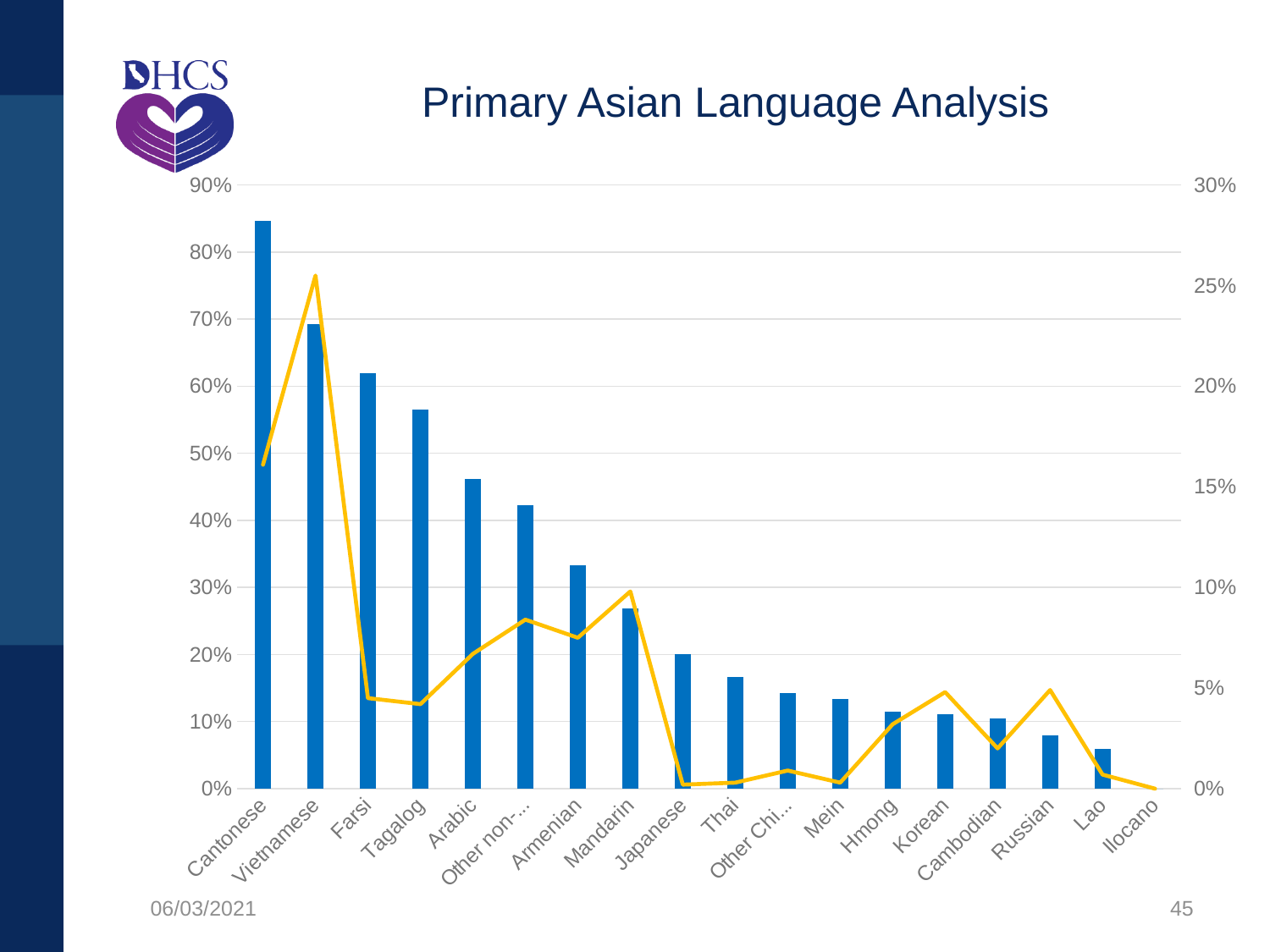
Do the bar values generally rise or fall moving from left to right along the x axis? Fall What is the highest tick value shown on the right-hand axis? 30% How many language categories are shown along the x axis? 18 What kind of chart is shown on the slide? A bar chart combined with a line chart Is the bar for Tagalog greater or less than 60%? less Which has the taller bar, Armenian or Mandarin? Armenian Is the bar for Thai greater or less than 20%? less Is the bar for Cantonese greater or less than 80%? greater At which language does the yellow line reach its highest point? Vietnamese Which has the taller bar, Farsi or Tagalog? Farsi Which language has the tallest bar? Cantonese